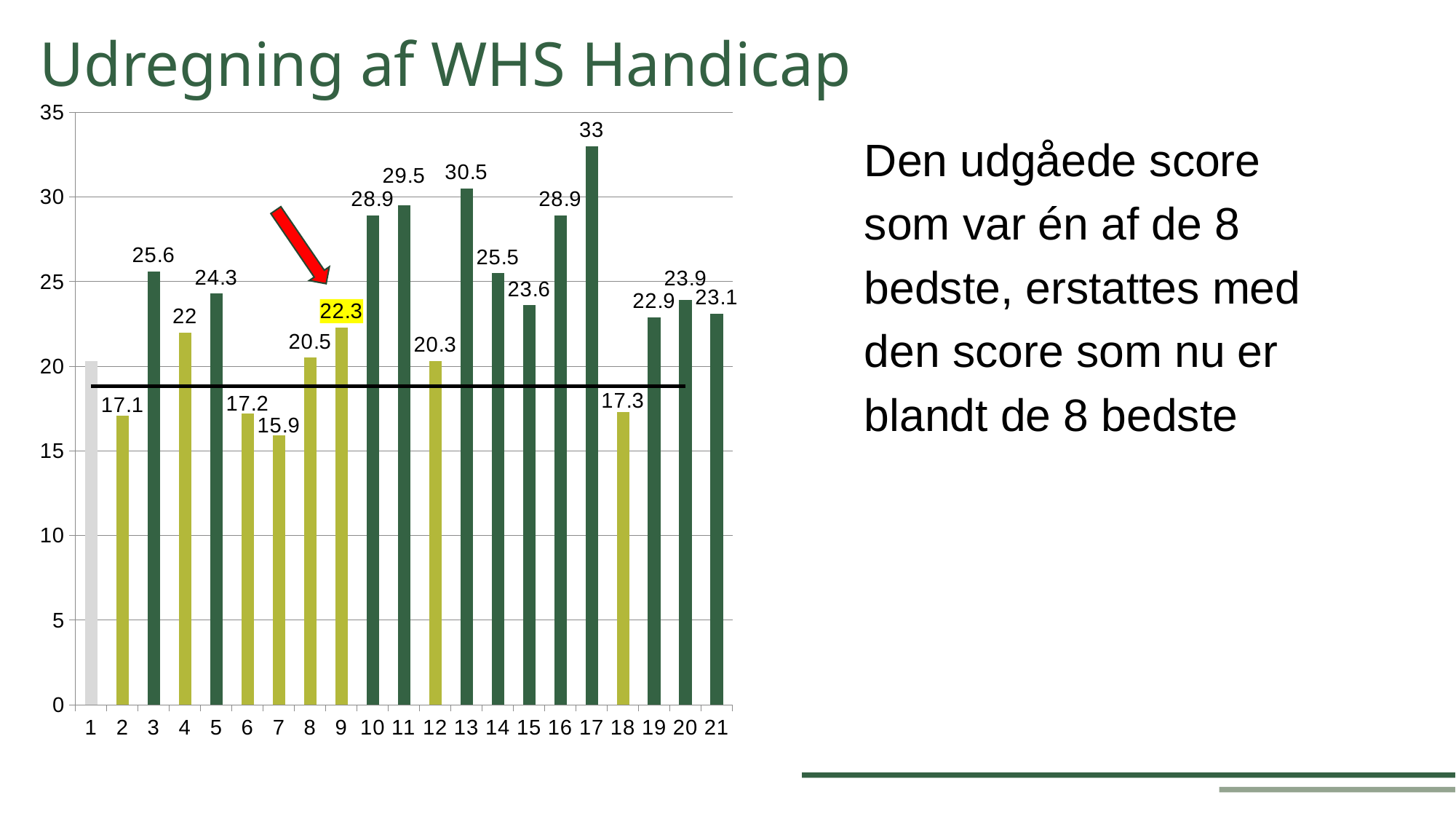
What is the value for category 17? 33 Which category has the lowest value? 7 Which is larger, the value for category 11 or the value for category 10? Category 11 What kind of chart is shown on the slide? Bar chart Which category has the highest value? 17 How many categories are shown on the x axis? 21 What is the difference between the values for category 17 and category 13? 2.5 What is the value for category 20? 23.9 What is the value for category 7? 15.9 What is the value of the bar highlighted in yellow at category 9? 22.3 Is the value for category 18 greater or less than 20? less What is the title of the slide containing the chart? Udregning af WHS Handicap